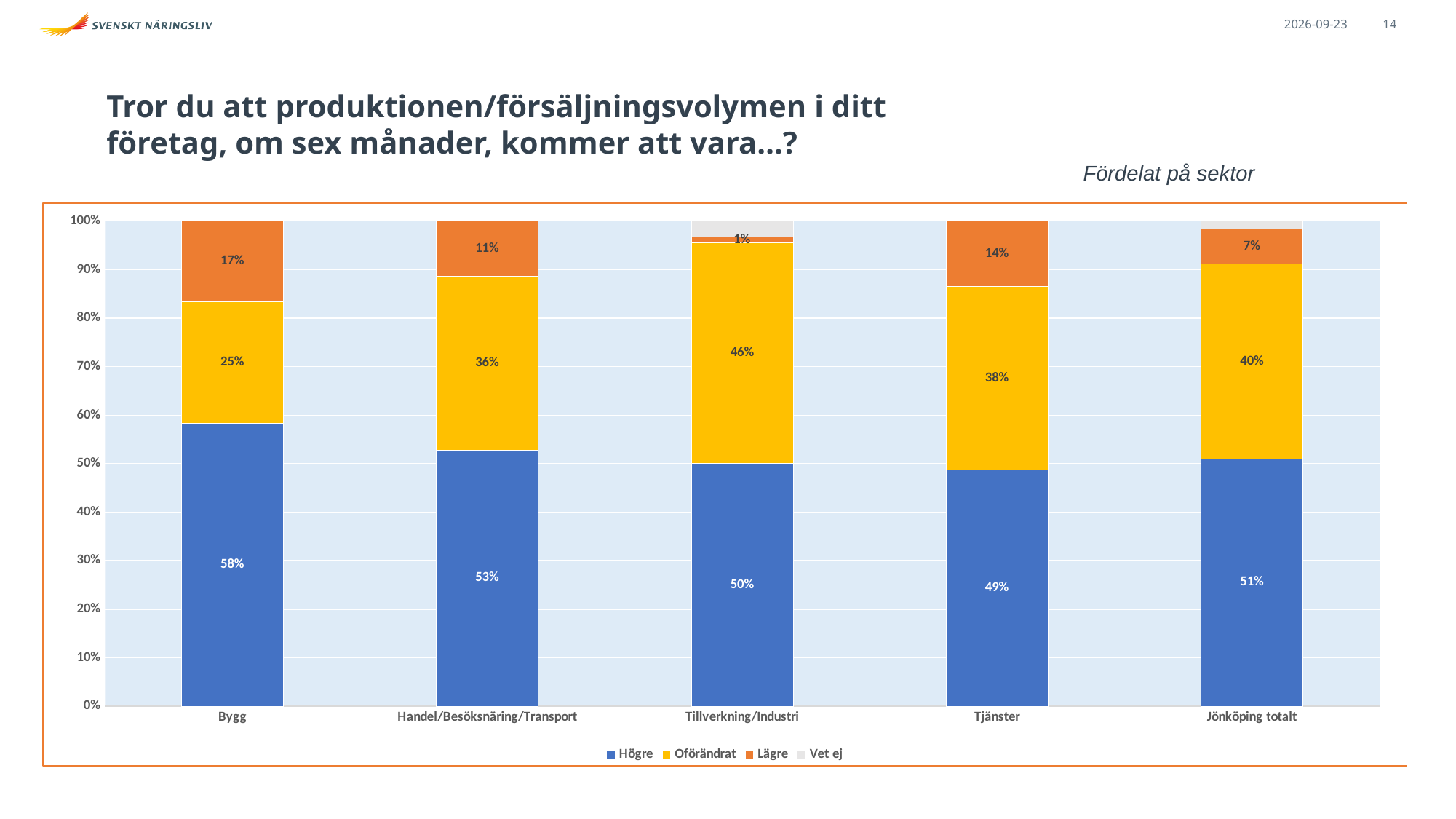
What kind of chart is shown on the slide? Stacked bar chart How many series does the legend list? 4 Is the Vet ej value for Tillverkning/Industri greater or less than 10%? less What is the Lägre value for Tjänster? 14% Which sector has the lowest Lägre share? Tillverkning/Industri What percentage of respondents in Bygg answered Högre? 58% What is the Oförändrat share for Tillverkning/Industri? 46% Which is larger: the Oförändrat share for Handel/Besöksnäring/Transport or for Tjänster? Tjänster What is the Lägre value for Jönköping totalt? 7% What is the difference between the Högre share for Bygg and for Tjänster? 9 percentage points Which sector has the highest Högre share? Bygg How many sectors are shown on the x axis? 5